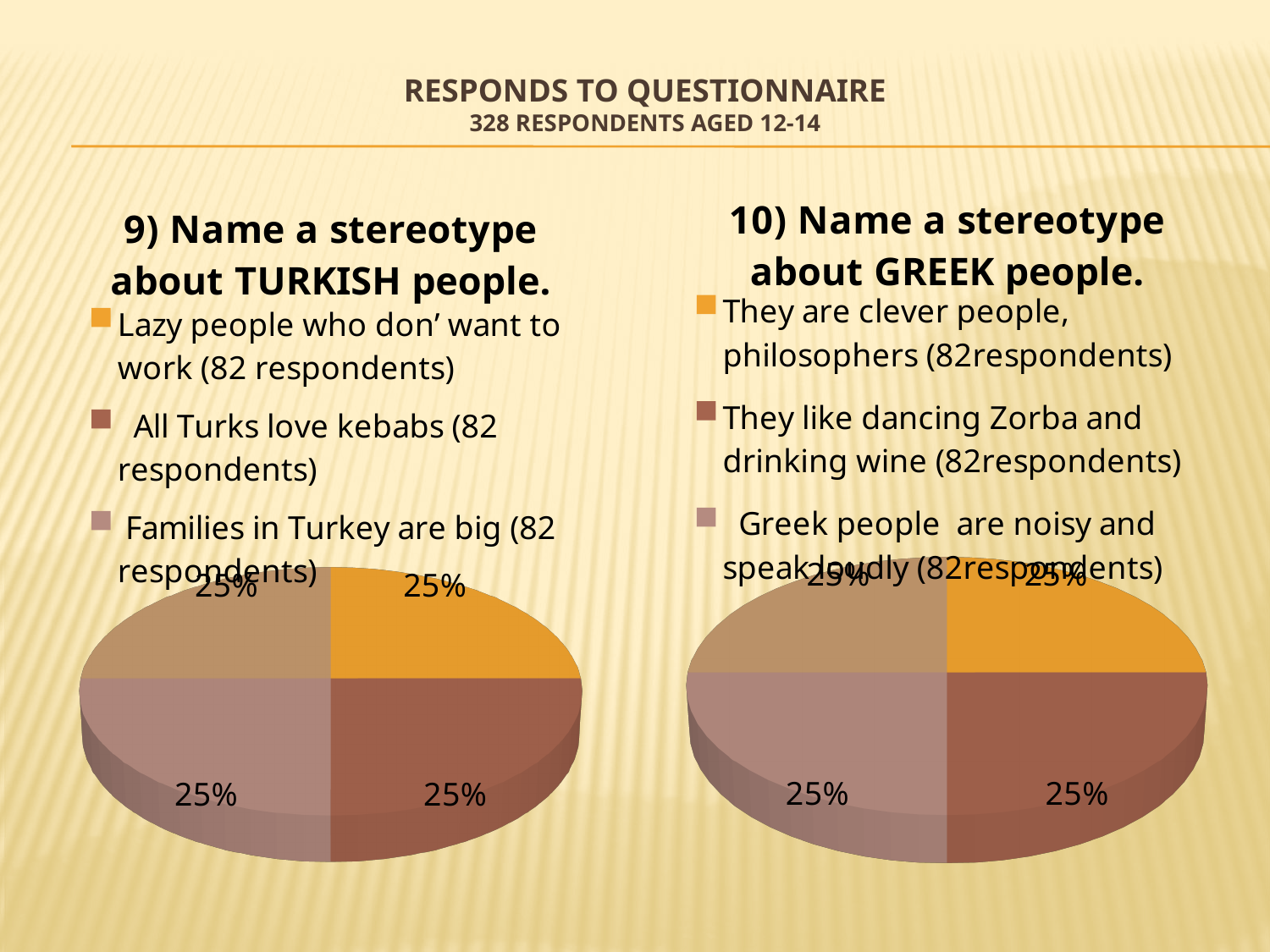
In the chart about GREEK people, what share of the pie is the orange slice for 'They are clever people, philosophers'? 25% In the chart about TURKISH people, how many slices does the pie have? 4 In the chart about TURKISH people, is the slice for 'All Turks love kebabs' larger than, smaller than, or equal to the slice for 'Families in Turkey are big'? equal How many legend entries are listed for the chart about TURKISH people? 3 What kind of chart is shown under '9) Name a stereotype about TURKISH people.'? pie chart In the chart about GREEK people, is the slice for 'They like dancing Zorba and drinking wine' larger than, smaller than, or equal to the slice for 'Greek people are noisy and speak loudly'? equal What kind of chart is shown under '10) Name a stereotype about GREEK people.'? pie chart How many respondents are stated in the slide subtitle? 328 In the chart about GREEK people, how many slices does the pie have? 4 In the chart about TURKISH people, what share of the pie is the orange slice for 'Lazy people who don' want to work'? 25% In the chart about GREEK people, what percentage is labelled on each slice? 25% In the chart about TURKISH people, what percentage is labelled on each slice? 25%